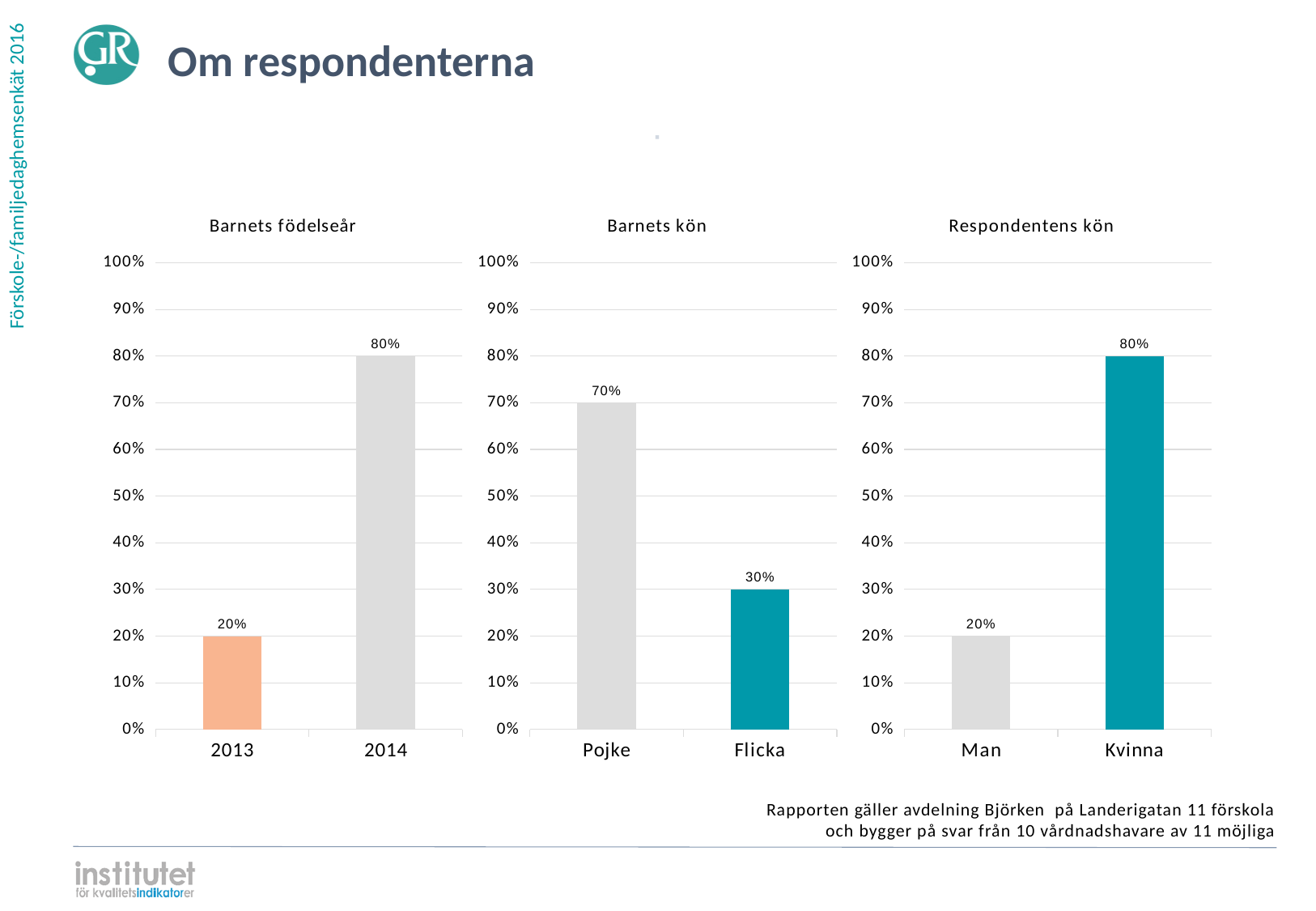
In the 'Respondentens kön' chart, what is the value for Kvinna? 80% In the 'Barnets födelseår' chart, what is the value for 2014? 80% In the 'Barnets födelseår' chart, what is the value for 2013? 20% How many categories are shown in the 'Respondentens kön' chart? 2 In the 'Respondentens kön' chart, which category has the lowest value? Man In the 'Barnets födelseår' chart, what is the difference between 2014 and 2013? 60% What kind of chart is the 'Barnets födelseår' chart? Bar chart In the 'Barnets kön' chart, which is larger, Pojke or Flicka? Pojke In the 'Barnets kön' chart, what is the value for Flicka? 30% In the 'Barnets kön' chart, what is the difference between Pojke and Flicka? 40% How many charts are shown on the slide? 3 In the 'Barnets kön' chart, what is the value for Pojke? 70%